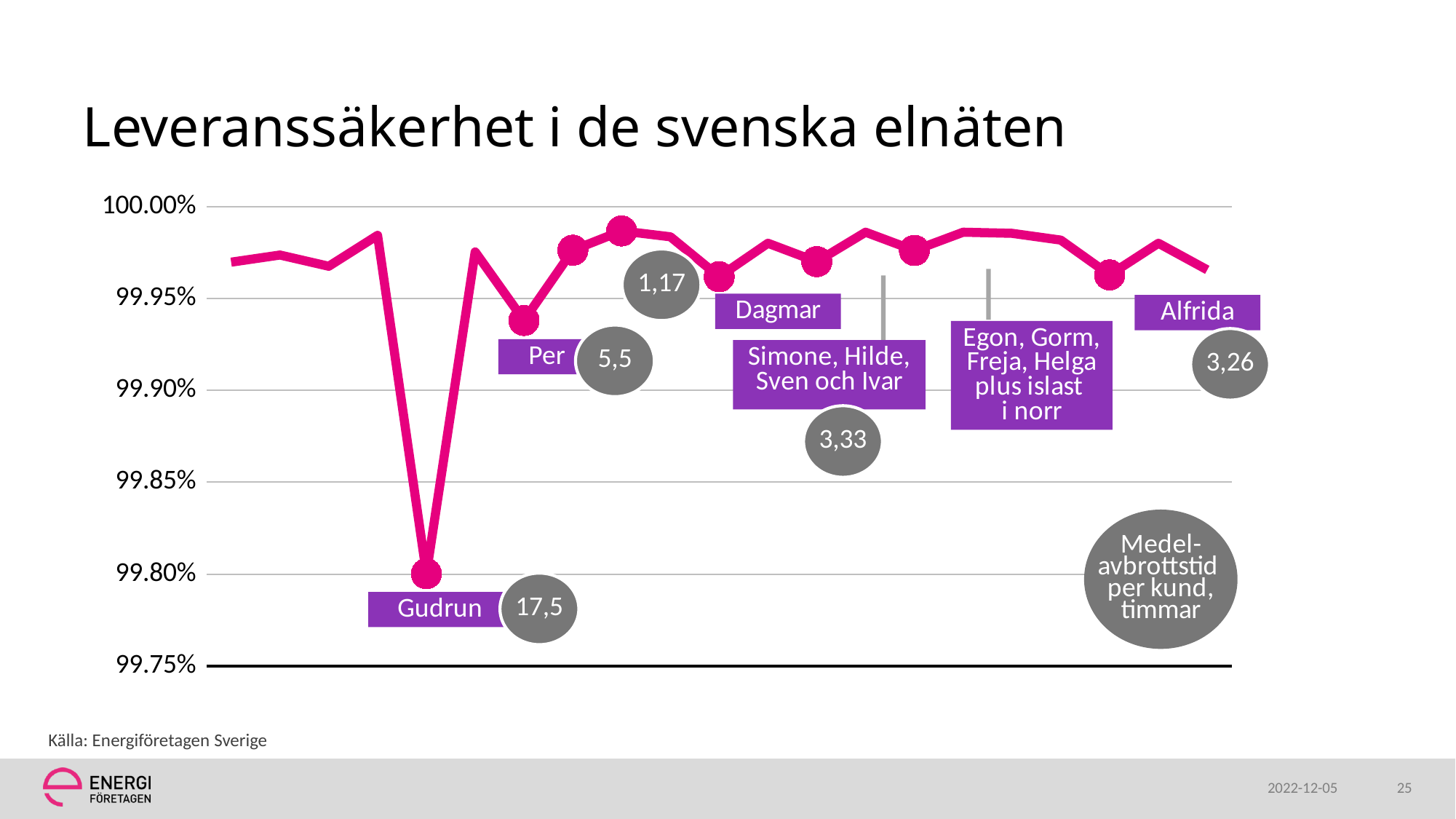
What average outage time per customer (hours) is annotated for Alfrida? 3,26 What kind of chart is shown on the slide? line chart What is the difference between the annotated outage times for Gudrun (17,5) and Per (5,5)? 12 What is the title of the slide's chart? Leveranssäkerhet i de svenska elnäten Which storm has the larger annotated average outage time, Gudrun or Per? Gudrun What average outage time per customer (hours) is annotated for Per? 5,5 What average outage time per customer (hours) is annotated for Gudrun? 17,5 Is the value at the Alfrida point greater or less than 99.95%? greater Is the value at the Per point greater or less than 99.95%? less Which storm is annotated at the lowest point of the line? Gudrun What average outage time per customer (hours) is annotated for Simone, Hilde, Sven och Ivar? 3,33 Is the value at the Gudrun point greater or less than 99.85%? less